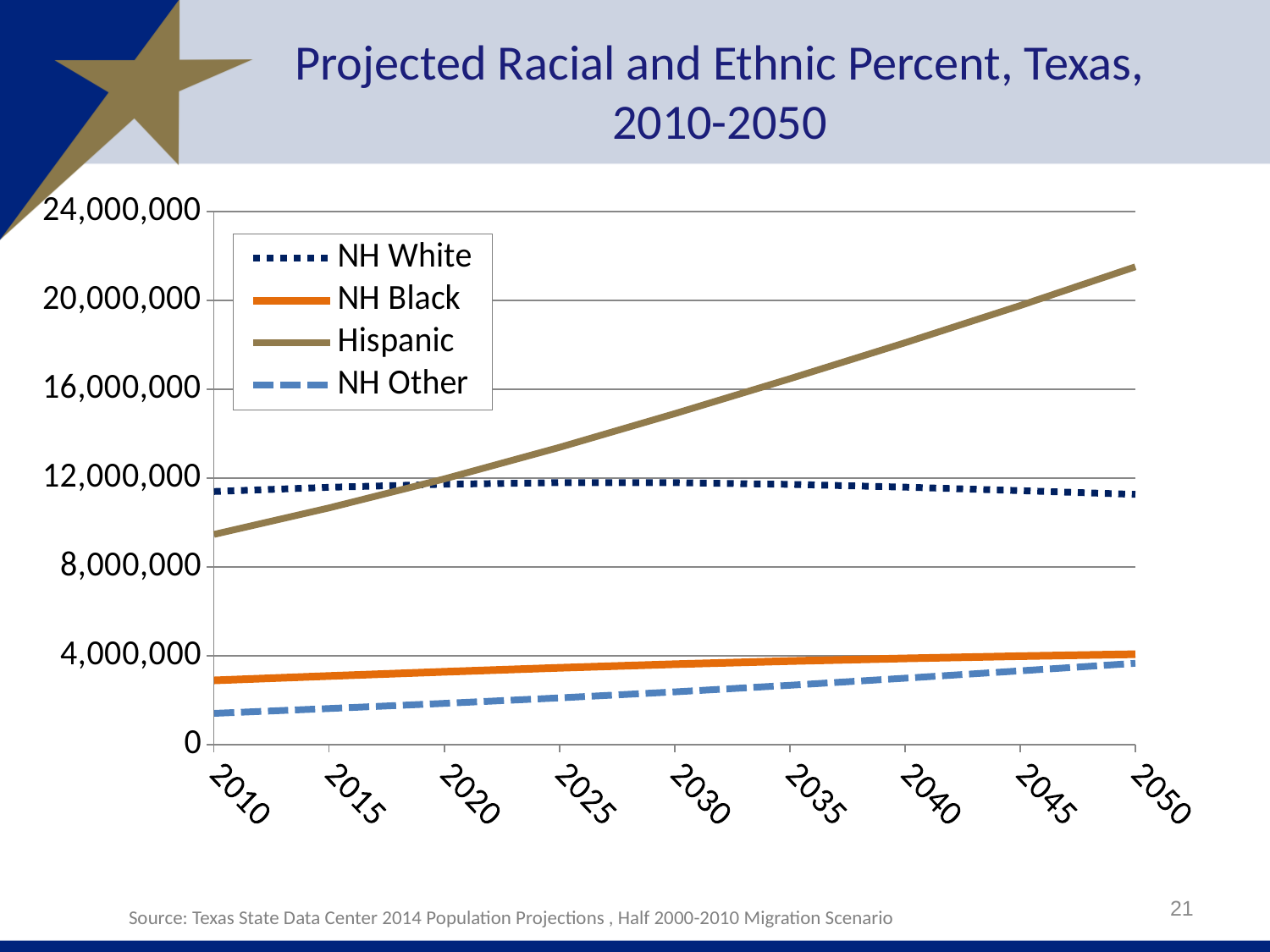
In 2010, which is larger: NH White or Hispanic? NH White Which series has the highest value in 2050? Hispanic In 2050, which is larger: Hispanic or NH White? Hispanic What kind of chart is shown on the slide? line chart How many series does the legend list? 4 How many years are labelled along the x axis? 9 Which series is drawn with a dotted line in the legend? NH White Does the Hispanic series rise or fall from 2010 to 2050? rise Which series has the lowest value in 2010? NH Other Is the value for Hispanic in 2010 greater or less than 12,000,000? less Is the value for Hispanic in 2050 greater or less than 20,000,000? greater Is the value for NH Other in 2010 greater or less than 4,000,000? less